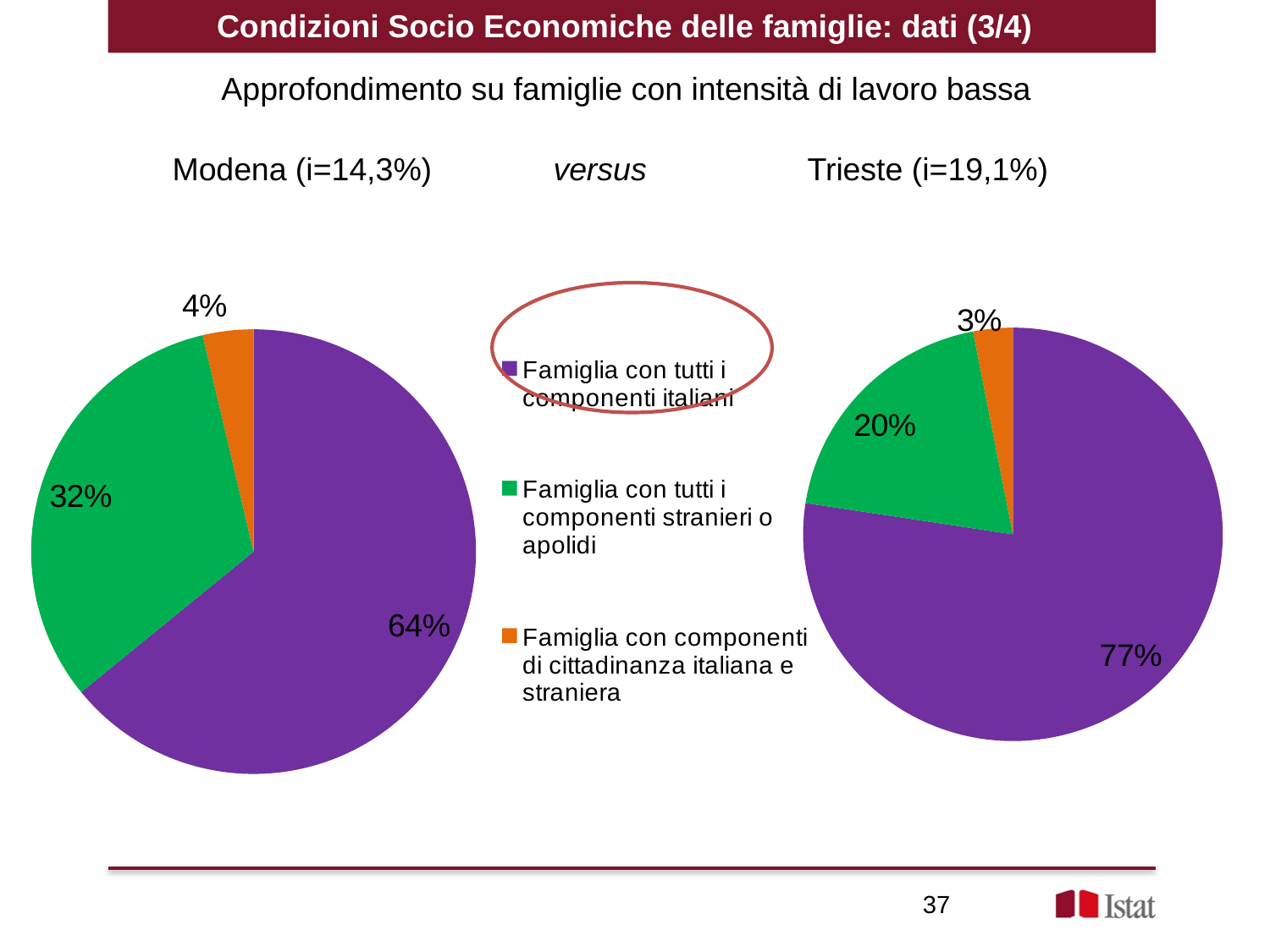
What is the difference between the share of 'Famiglia con tutti i componenti italiani' in Trieste and in Modena? 13% In the Modena pie chart, what share is shown for 'Famiglia con tutti i componenti italiani'? 64% What type of chart is used for Modena and Trieste on this slide? Pie chart In the Modena pie chart, what is the difference between the shares of 'Famiglia con tutti i componenti italiani' and 'Famiglia con tutti i componenti stranieri o apolidi'? 32% How many categories does the legend list? 3 In the Modena pie chart, what share is shown for 'Famiglia con componenti di cittadinanza italiana e straniera'? 4% Which colour represents 'Famiglia con tutti i componenti stranieri o apolidi' in the pie charts? Green In the Modena pie chart, which category has the largest slice? Famiglia con tutti i componenti italiani In the Trieste pie chart, what share is shown for 'Famiglia con tutti i componenti stranieri o apolidi'? 20% In the Trieste pie chart, what share is shown for 'Famiglia con tutti i componenti italiani'? 77% Which city has the larger share of 'Famiglia con tutti i componenti stranieri o apolidi', Modena or Trieste? Modena In the Trieste pie chart, which category has the smallest slice? Famiglia con componenti di cittadinanza italiana e straniera